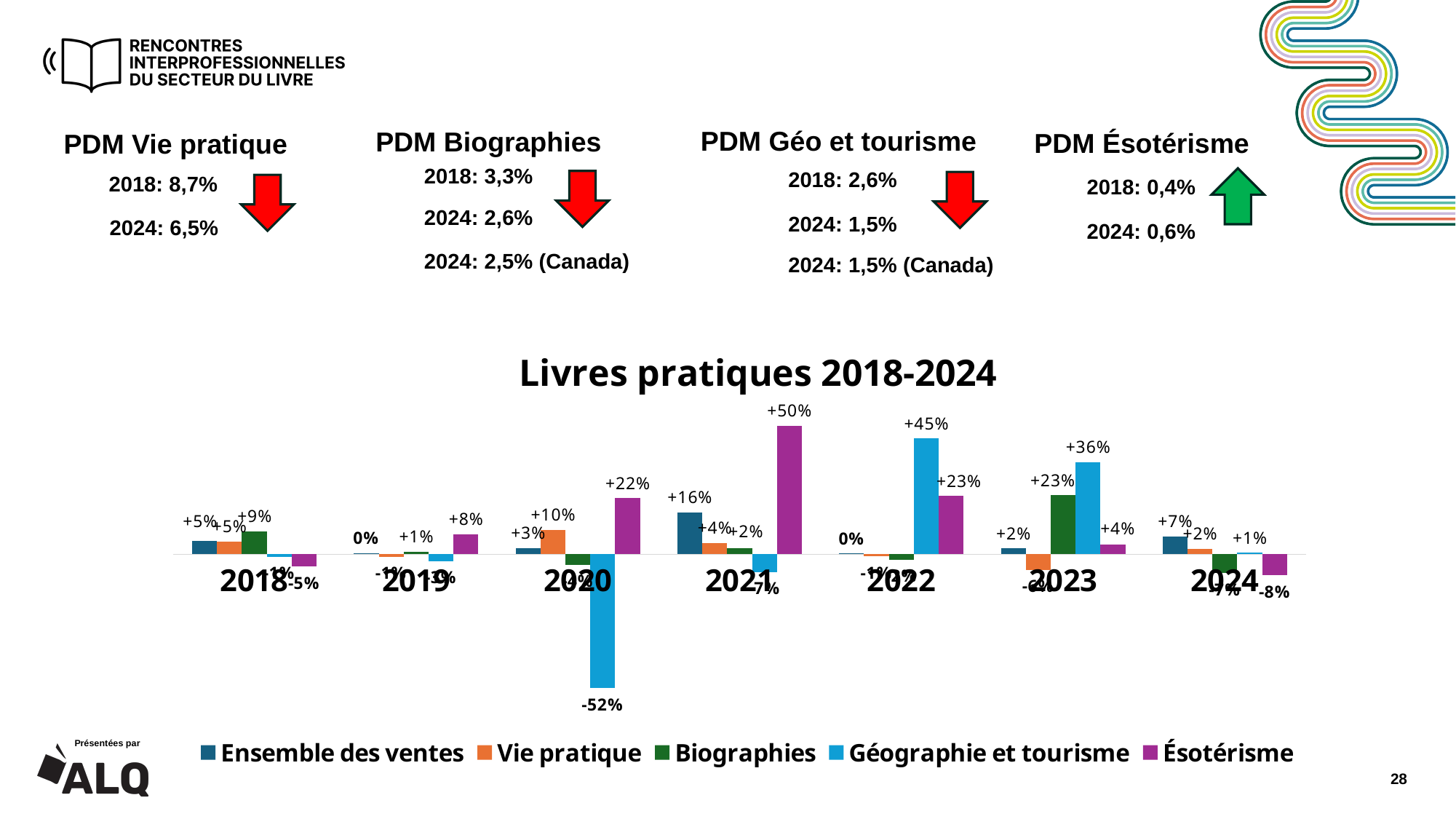
What is the value for Ésotérisme in 2021? +50% In which year does Ésotérisme reach its highest value? 2021 What kind of chart is shown on the slide? Bar chart What is the title of the chart? Livres pratiques 2018-2024 What is the difference between the Géographie et tourisme values in 2022 and 2023? 9 percentage points How many years are shown on the x axis of the 'Livres pratiques 2018-2024' chart? 7 What is the value for Géographie et tourisme in 2020? -52% How many series does the legend of the 'Livres pratiques 2018-2024' chart list? 5 What is the value for Ensemble des ventes in 2021? +16% In which year does Géographie et tourisme have its lowest value? 2020 In 2023, which is larger: Biographies or Géographie et tourisme? Géographie et tourisme What is the value for Vie pratique in 2020? +10%